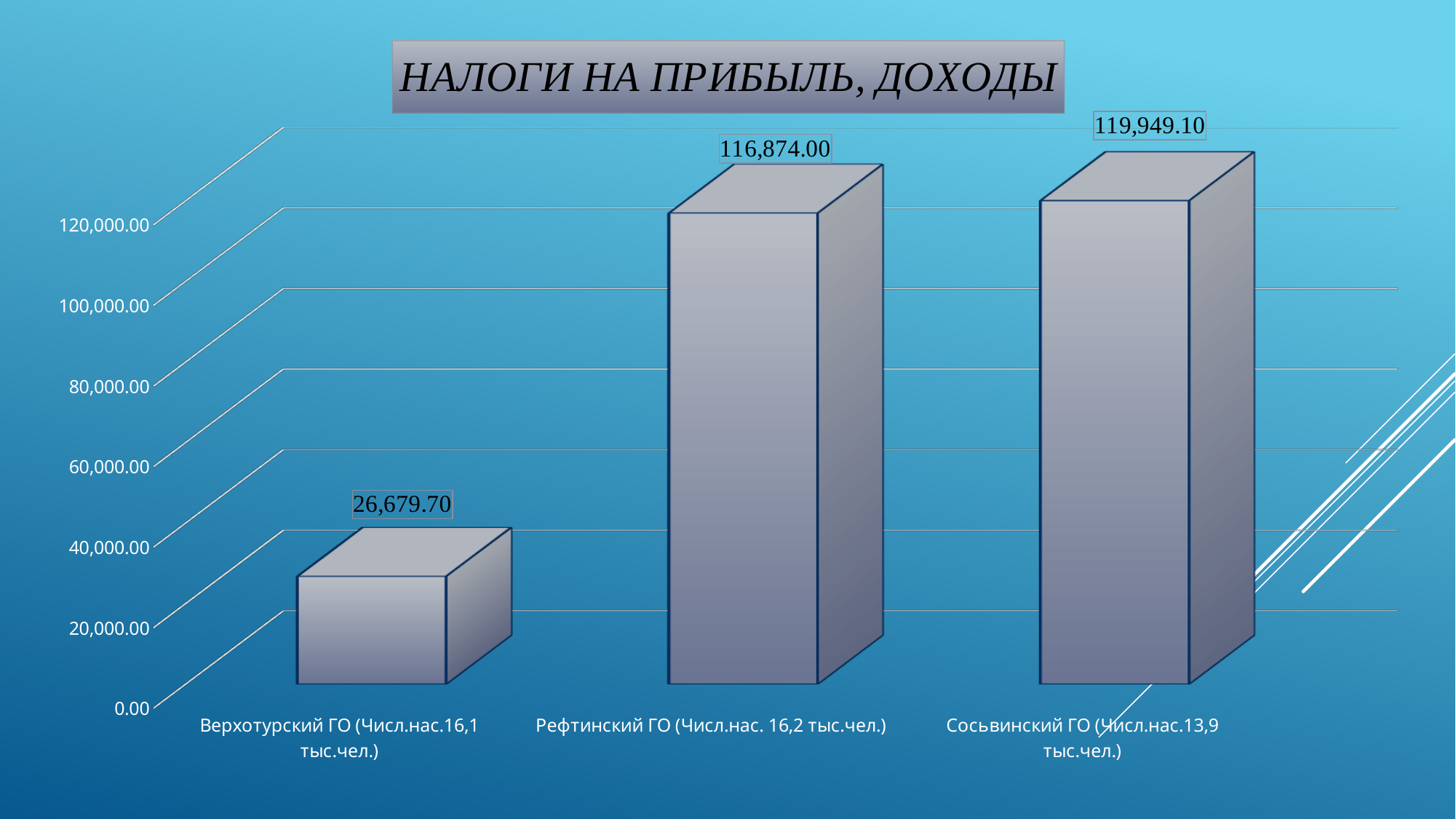
What is the title of the chart? НАЛОГИ НА ПРИБЫЛЬ, ДОХОДЫ What is the difference between the values for Сосьвинский ГО and Рефтинский ГО? 3,075.10 What is the difference between the values for Рефтинский ГО and Верхотурский ГО? 90,194.30 Which category has the highest value? Сосьвинский ГО Which category has the lowest value? Верхотурский ГО Is the value for Верхотурский ГО greater or less than 40,000.00? less What is the value for Рефтинский ГО? 116,874.00 Which is larger, the value for Рефтинский ГО or the value for Верхотурский ГО? Рефтинский ГО What is the value for Сосьвинский ГО? 119,949.10 What kind of chart is shown on the slide? bar chart What is the value for Верхотурский ГО? 26,679.70 How many categories are shown in the chart? 3